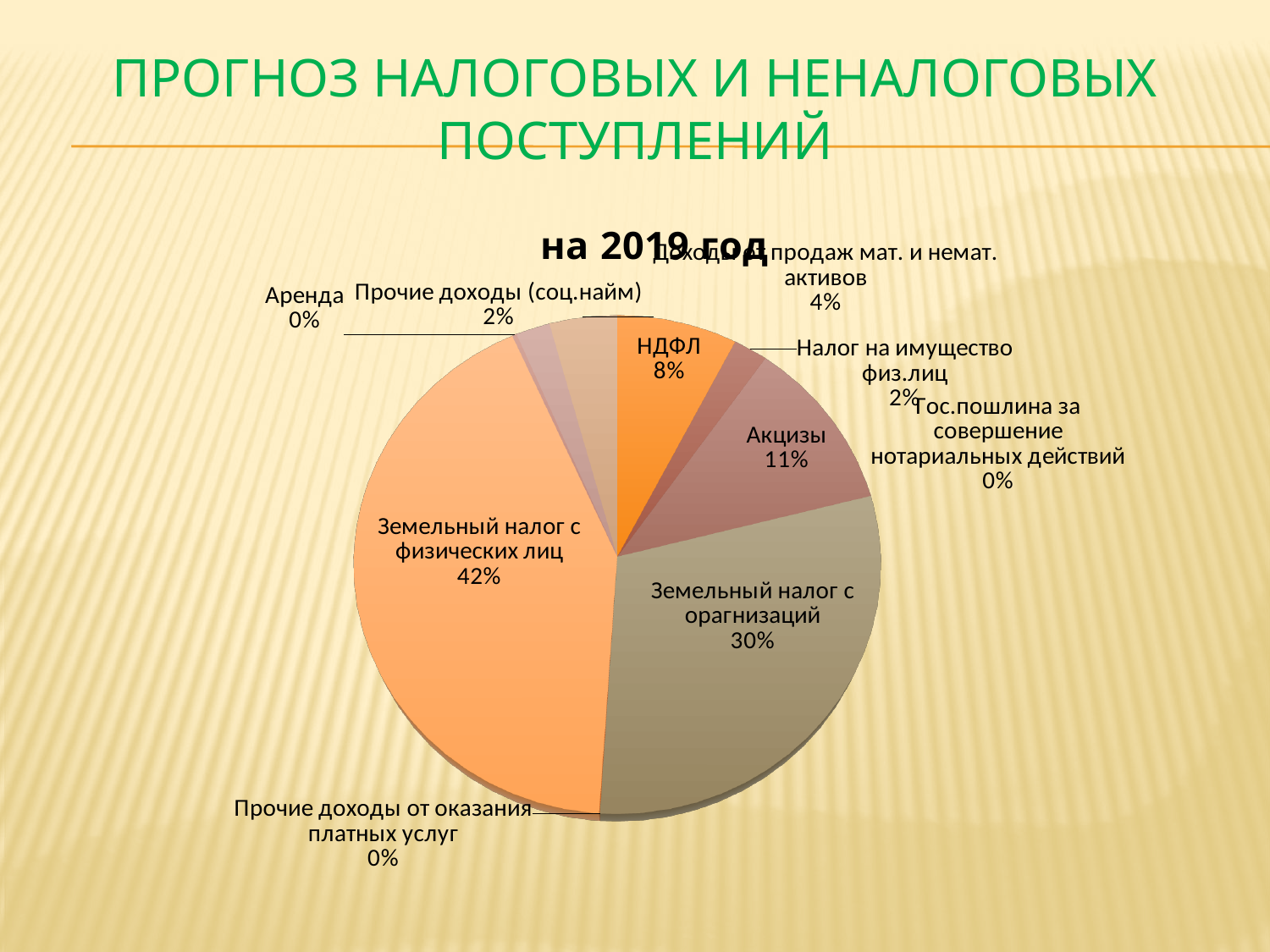
Which is larger, the share for "Акцизы" or the share for "НДФЛ"? Акцизы What is the title of the pie chart? на 2019 год Which category has the largest share of the pie? Земельный налог с физических лиц What is the difference between the shares of "Земельный налог с физических лиц" and "Земельный налог с орагнизаций"? 12% What is the value shown for "НДФЛ"? 8% What is the value shown for "Доходы от продаж мат. и немат. активов"? 4% What is the value shown for "Прочие доходы (соц.найм)"? 2% What share of the pie does "Земельный налог с физических лиц" have? 42% How many categories are shown in the pie chart? 10 What is the value shown for "Акцизы"? 11% What share of the pie does "Земельный налог с орагнизаций" have? 30% What kind of chart is shown on the slide? pie chart